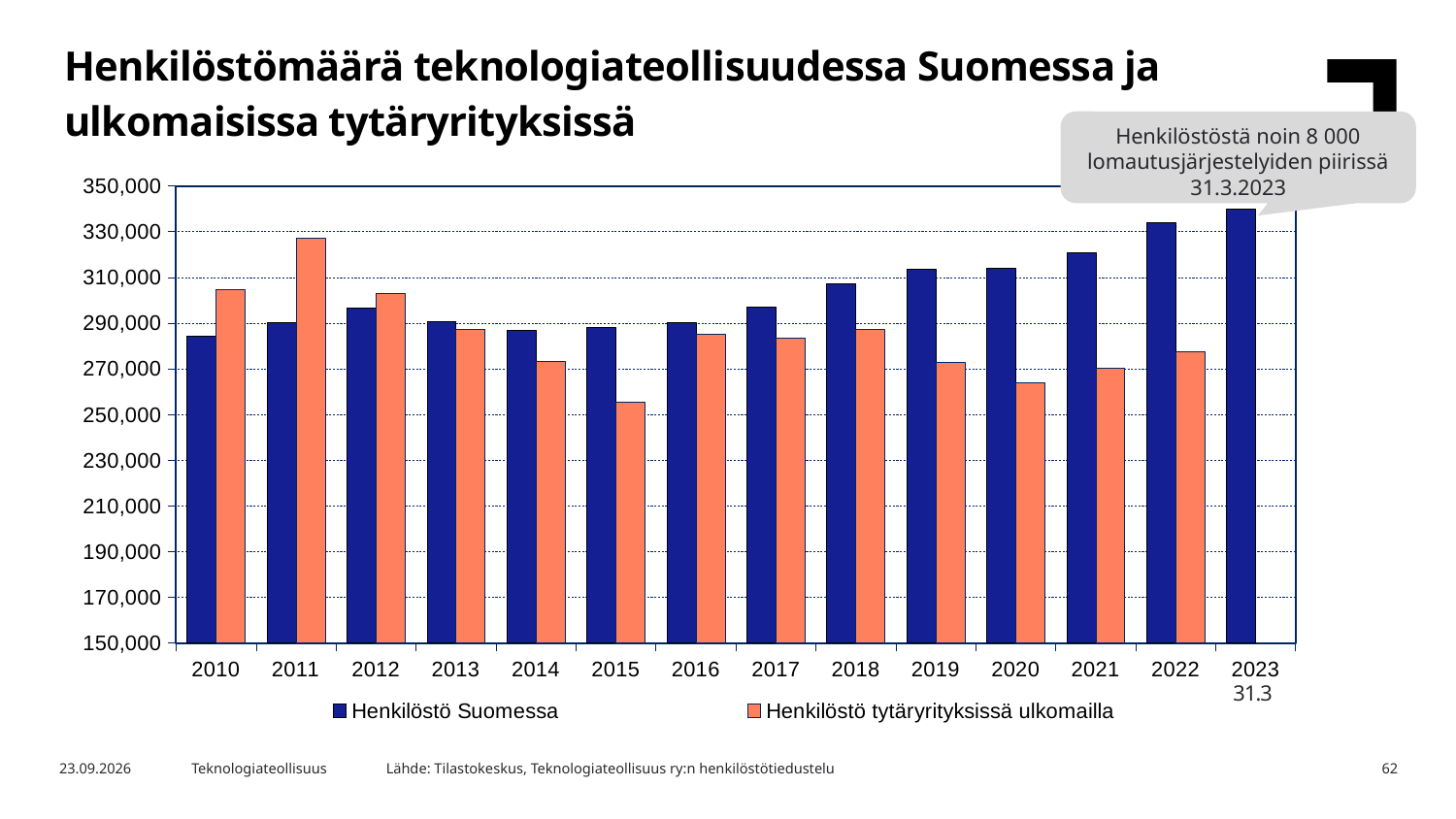
Is the value for Henkilöstö tytäryrityksissä ulkomailla in 2015 greater or less than 270,000? less Is the value for Henkilöstö tytäryrityksissä ulkomailla in 2011 greater or less than 310,000? greater In which year is the value for Henkilöstö Suomessa highest? 2023 How many series does the legend list? 2 What kind of chart is shown on the slide? bar chart How many years are shown on the x axis? 14 In which year is the value for Henkilöstö tytäryrityksissä ulkomailla lowest? 2015 Does the value for Henkilöstö Suomessa rise or fall from 2016 to 2023? rise In 2022, which series has the larger value: Henkilöstö Suomessa or Henkilöstö tytäryrityksissä ulkomailla? Henkilöstö Suomessa In which year is the value for Henkilöstö tytäryrityksissä ulkomailla highest? 2011 In 2010, which series has the larger value: Henkilöstö Suomessa or Henkilöstö tytäryrityksissä ulkomailla? Henkilöstö tytäryrityksissä ulkomailla Is the value for Henkilöstö Suomessa in 2023 greater or less than 330,000? greater